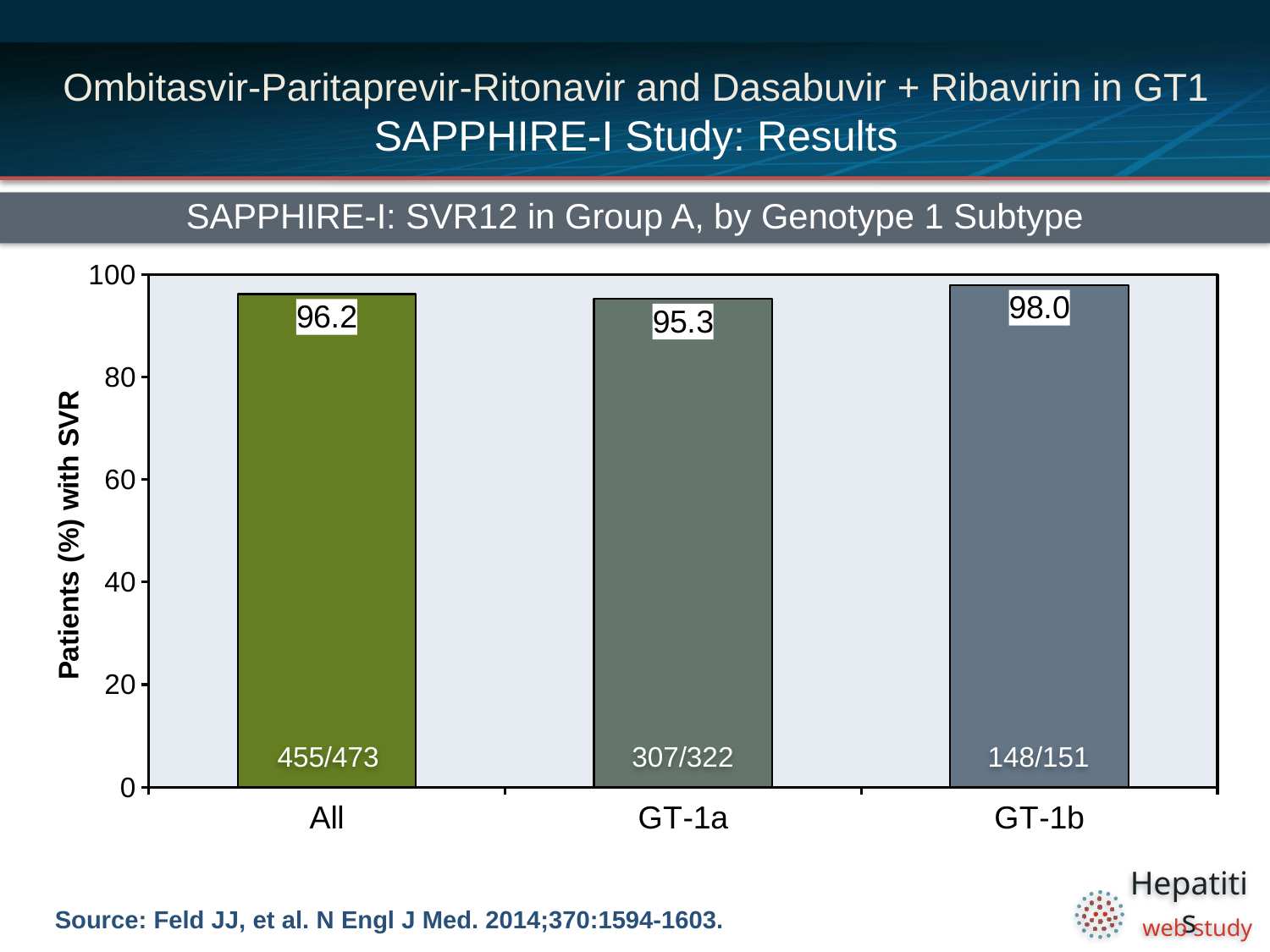
What is the difference in SVR12 rate between GT-1b and GT-1a? 2.7 What is the label of the y axis? Patients (%) with SVR Which category has the lowest SVR12 rate? GT-1a What fraction of patients achieved SVR in the All group? 455/473 What is the SVR12 rate (%) for GT-1b? 98.0 What is the SVR12 rate (%) for the All group? 96.2 What fraction of patients achieved SVR in the GT-1b group? 148/151 How many categories are shown on the x axis? 3 Which has a higher SVR12 rate, GT-1a or GT-1b? GT-1b What is the SVR12 rate (%) for GT-1a? 95.3 Which genotype subtype has the highest SVR12 rate? GT-1b What type of chart is shown on the slide? Bar chart